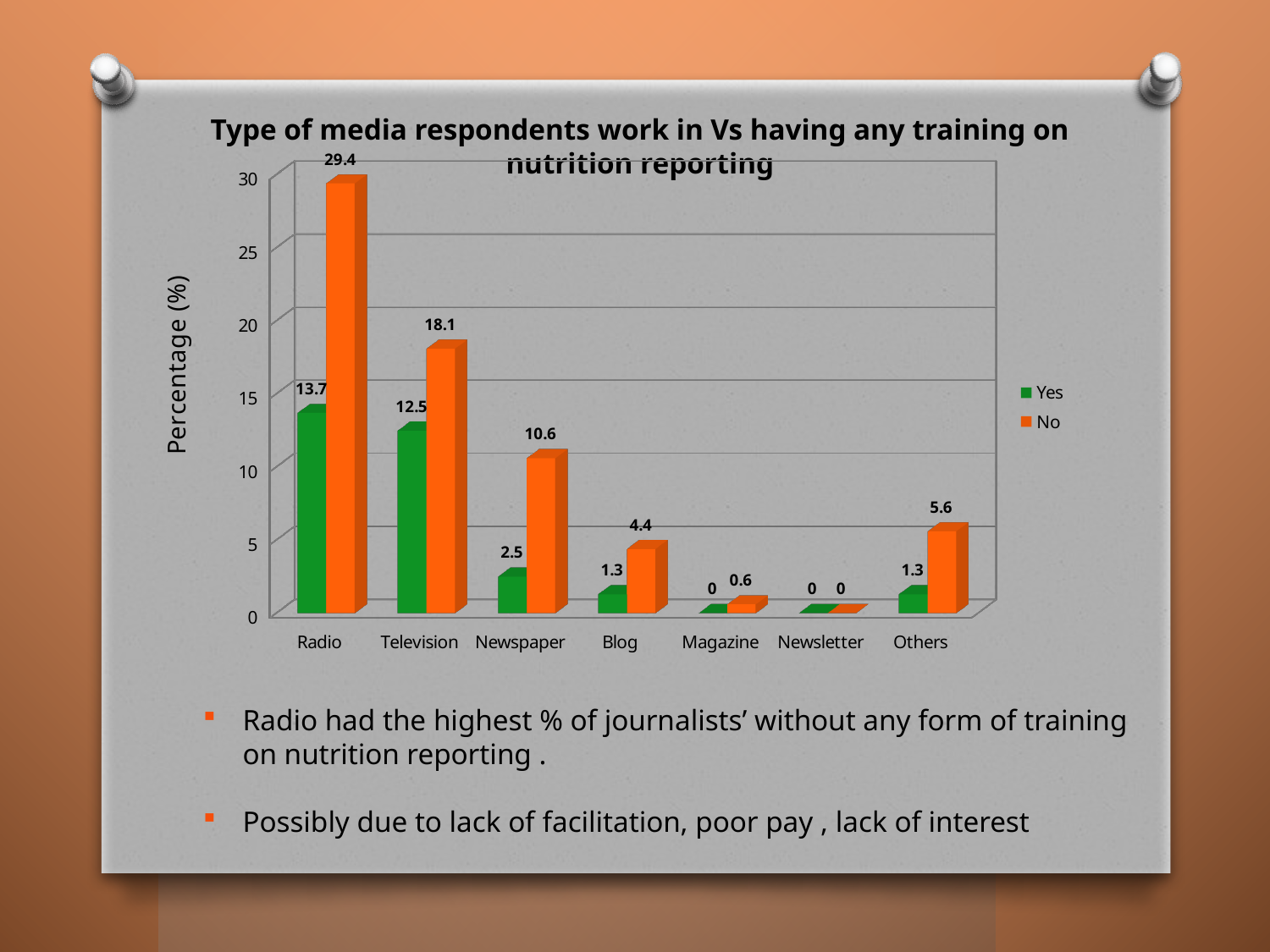
What is the 'Yes' value for Others? 1.3 What is the label of the y axis? Percentage (%) What is the difference between the 'No' and 'Yes' values for Radio? 15.7 Which is larger for Blog: the 'Yes' value or the 'No' value? No Which media type has the highest 'No' value? Radio Which media type has the lowest 'No' value? Newsletter What is the 'No' value for Newspaper? 10.6 How many series does the legend list? 2 What kind of chart is shown on the slide? Bar chart What is the 'Yes' value for Television? 12.5 What is the 'No' value for Radio? 29.4 How many media types are shown on the x axis? 7